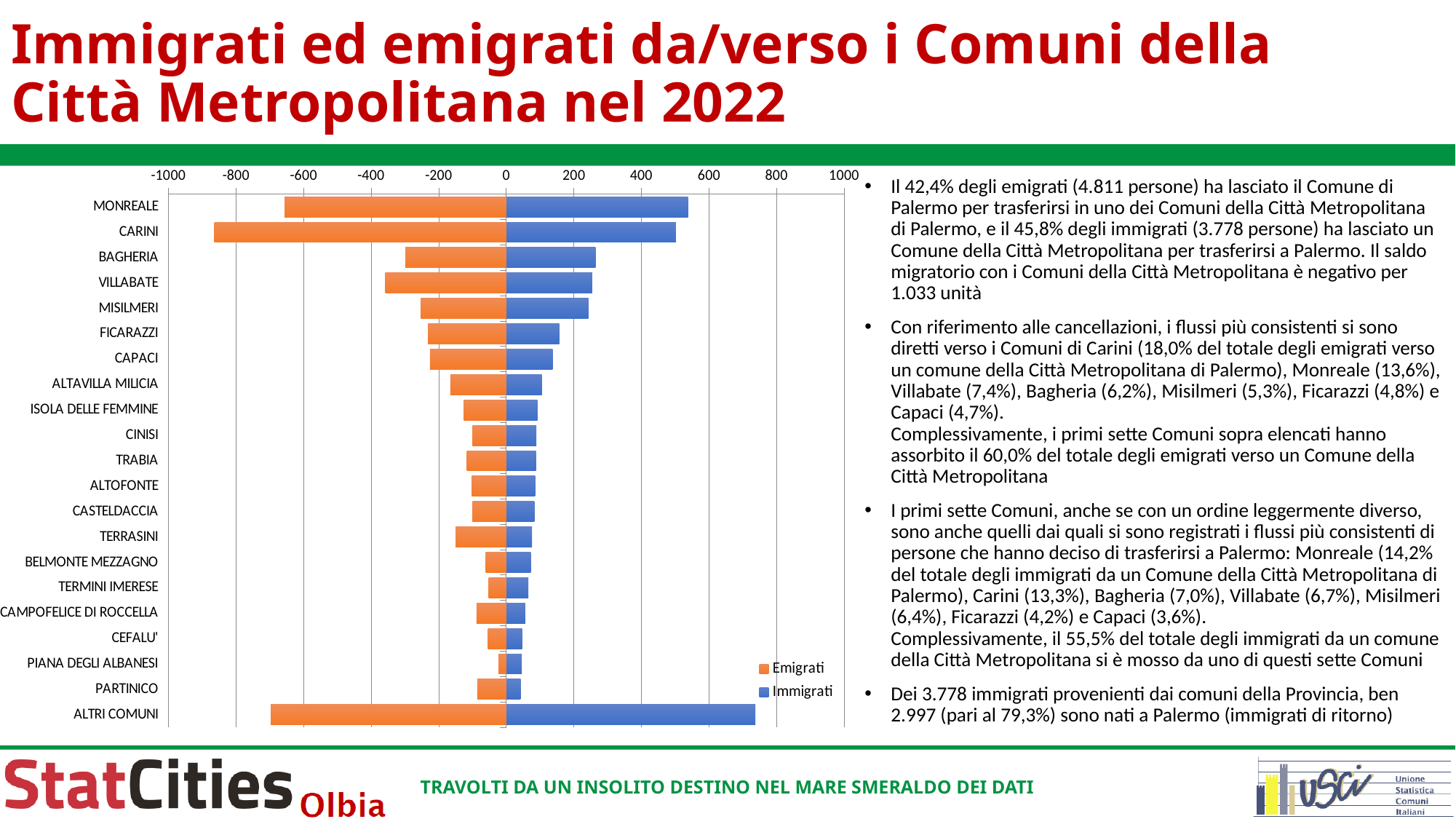
How many series does the chart legend list? 2 Is the Immigrati value for ALTRI COMUNI greater or less than 600? greater Which category has the longest Immigrati bar? ALTRI COMUNI How many categories (comuni) are plotted on the chart? 21 Which has a larger Immigrati value, MONREALE or BAGHERIA? MONREALE Is the Emigrati value for CARINI greater or less than -800? less Which category has the longest Emigrati bar (the largest number of emigrants)? CARINI Is the Immigrati value for MONREALE greater or less than 400? greater What kind of chart is shown on the slide? bar chart Which colour represents the Emigrati series in the chart? orange Which has a longer Emigrati bar, TERRASINI or BELMONTE MEZZAGNO? TERRASINI